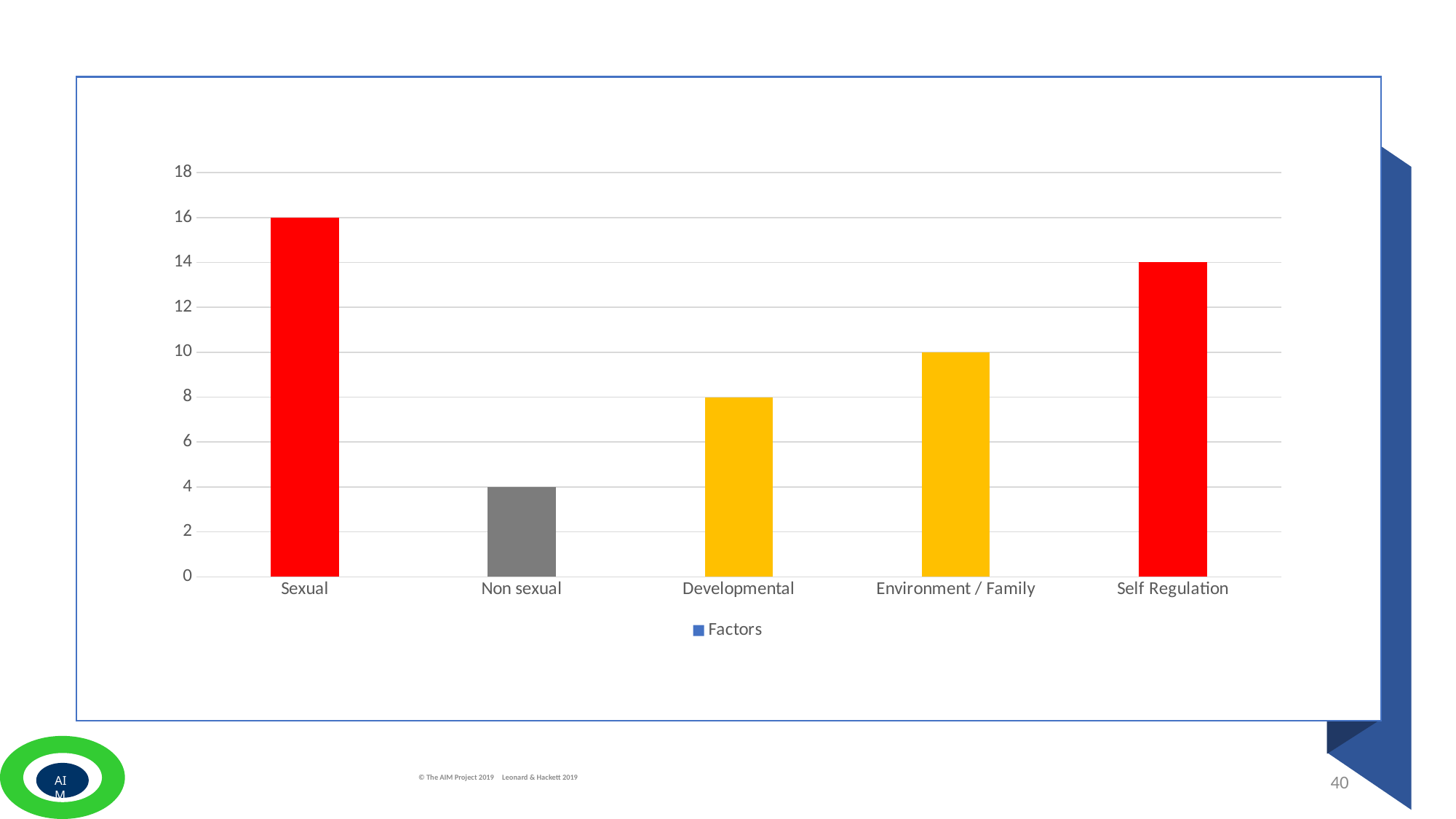
Which is larger, the value for Developmental or the value for Self Regulation? Self Regulation What kind of chart is shown on the slide? bar chart What series name does the legend show? Factors How many categories are shown on the x axis? 5 Is the value for Developmental greater or less than 10? less What is the value for Environment / Family? 10 Which category has the lowest value? Non sexual What is the value for Sexual? 16 Which category has the highest value? Sexual What is the difference between the values for Environment / Family and Developmental? 2 What is the difference between the values for Sexual and Self Regulation? 2 What is the value for Non sexual? 4